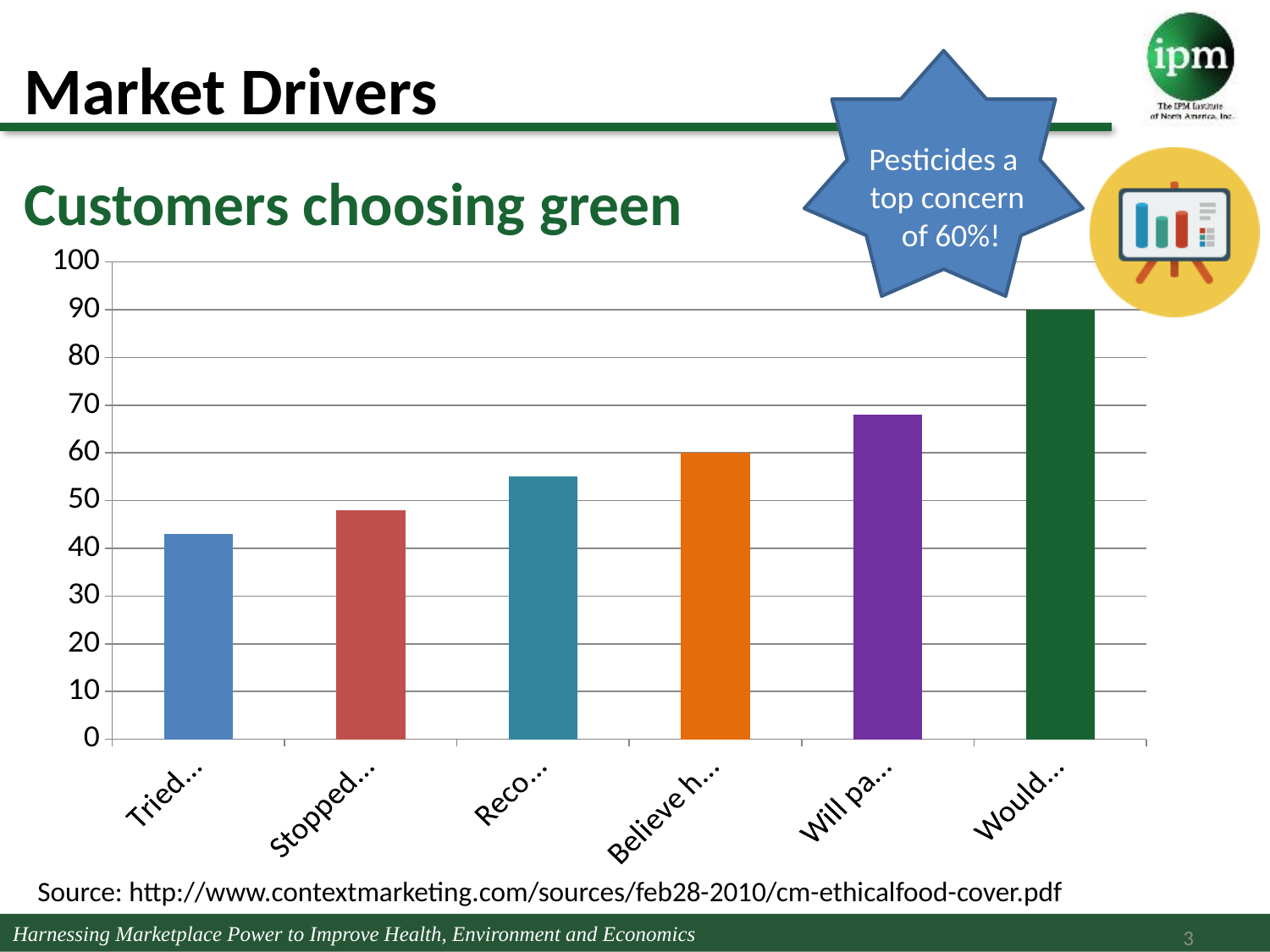
Is the value for "Tried..." greater or less than 50? less How many bars are plotted in the chart? 6 Which category has the lowest bar in the chart? Tried... What is the highest value shown on the vertical axis? 100 Is the value for "Will pa..." greater or less than 60? greater Which category has the highest bar in the chart? Would... What kind of chart is shown on the slide? bar chart What is the title of the chart? Customers choosing green Which is larger, the value for "Will pa..." or the value for "Stopped..."? Will pa... Is the value for "Reco..." greater or less than 50? greater Do the bar values rise or fall from left to right across the chart? rise